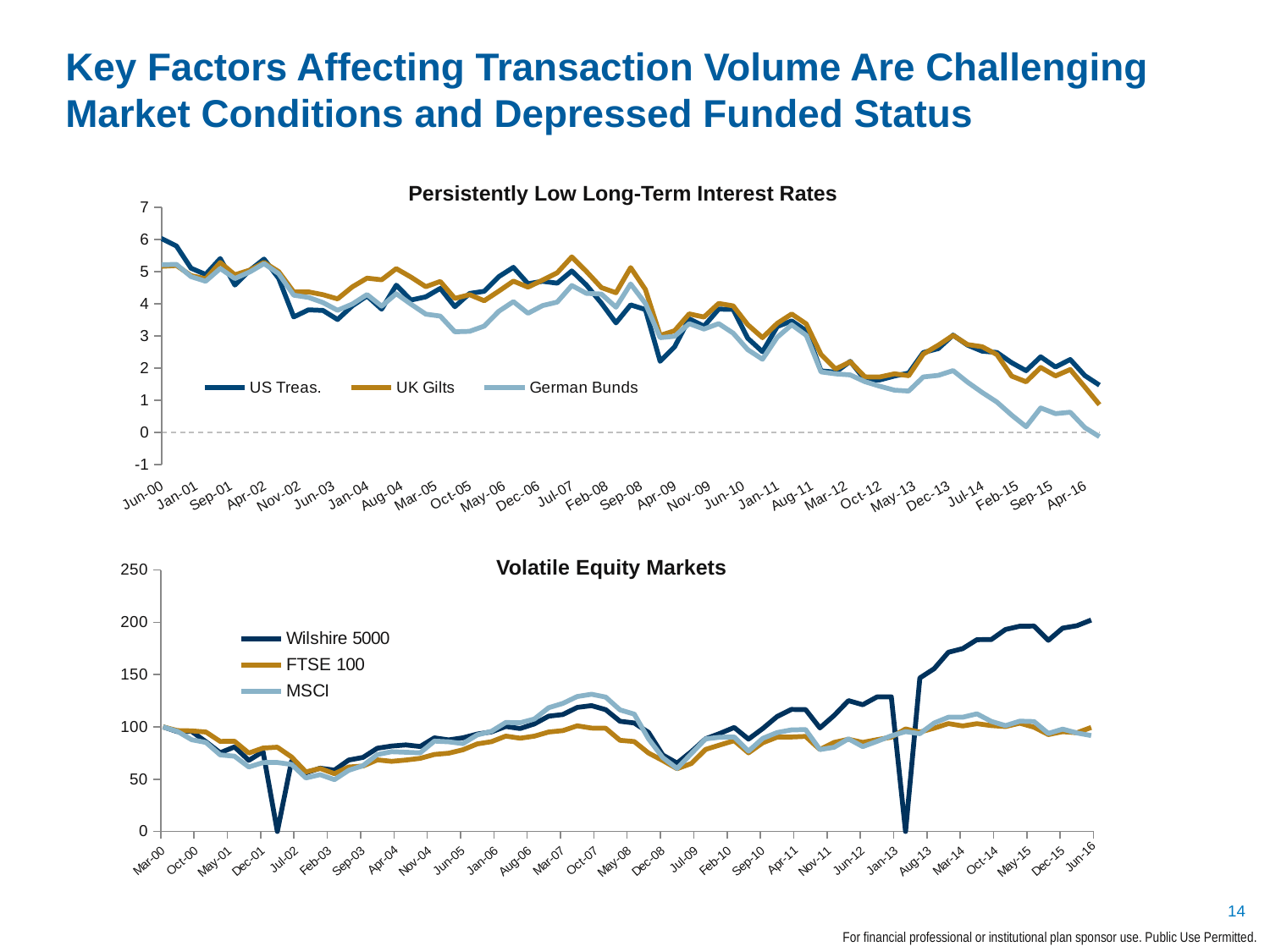
How many series does the legend of the "Volatile Equity Markets" chart list? 3 In the "Persistently Low Long-Term Interest Rates" chart, is the value for US Treas. at Jun-00 greater or less than 5? greater What kind of chart is the "Volatile Equity Markets" chart? Line chart In the "Volatile Equity Markets" chart, which is higher at Jun-16, Wilshire 5000 or FTSE 100? Wilshire 5000 In the "Persistently Low Long-Term Interest Rates" chart, which series are listed in the legend? US Treas., UK Gilts, German Bunds In the "Persistently Low Long-Term Interest Rates" chart, which is higher at Apr-16, US Treas. or German Bunds? US Treas. In the "Volatile Equity Markets" chart, which series are listed in the legend? Wilshire 5000, FTSE 100, MSCI In the "Volatile Equity Markets" chart, is the value for Wilshire 5000 at Jun-16 greater or less than 150? greater How many series does the legend of the "Persistently Low Long-Term Interest Rates" chart list? 3 What kind of chart is the "Persistently Low Long-Term Interest Rates" chart? Line chart In the "Persistently Low Long-Term Interest Rates" chart, do the interest rates generally rise or fall from Jun-00 to Apr-16? Fall In the "Persistently Low Long-Term Interest Rates" chart, is the value for German Bunds at Apr-16 greater or less than 1? less